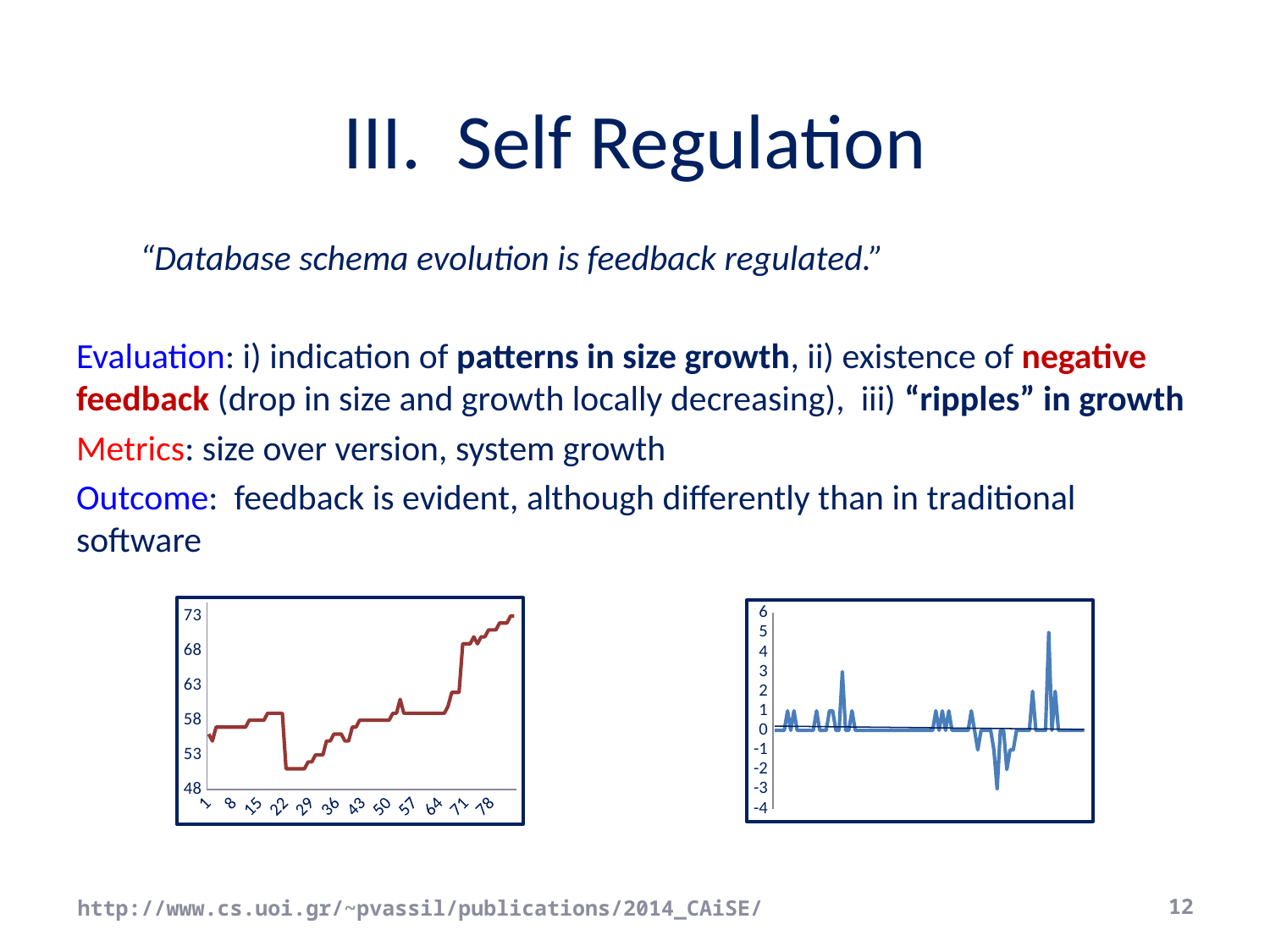
In the left chart, is the value at version 1 greater or less than 53? greater What is the lowest value labelled on the y axis of the left chart? 48 In the left chart, is the value at version 78 greater or less than 68? greater What kind of chart is the chart on the right of the slide? line chart In the right chart, is the highest peak of the line greater or less than 4? greater What kind of chart is the chart on the left of the slide? line chart In the left chart, do the values generally rise or fall from version 1 to version 78? rise What is the highest value labelled on the y axis of the right chart? 6 How many tick labels are shown on the x axis of the left chart? 12